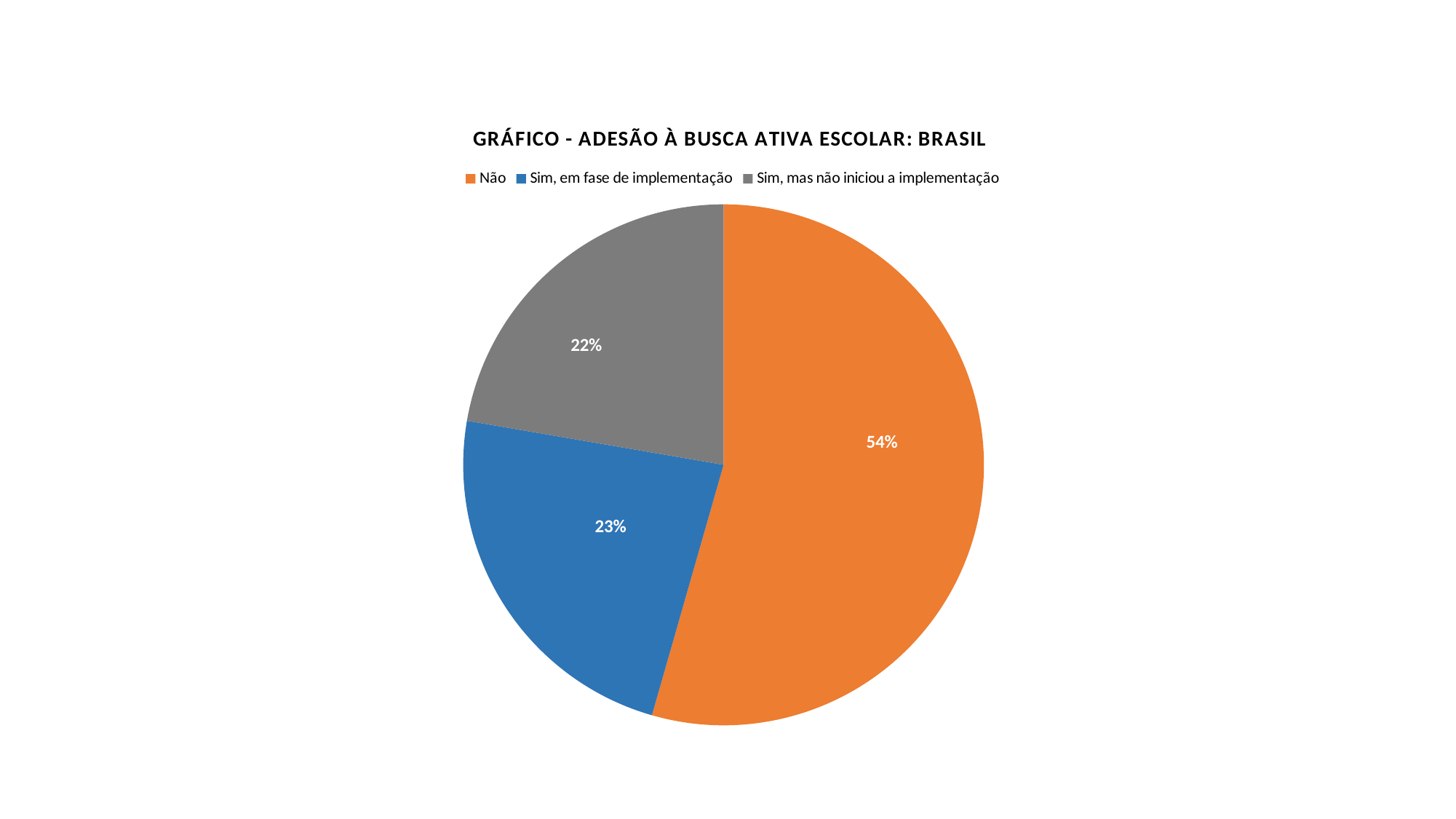
How many entries does the legend list? 3 What type of chart is shown on the slide? Pie chart What is the difference between the "Não" share and the "Sim, em fase de implementação" share? 31% Which category has the largest slice of the pie? Não Is the share for "Não" greater or less than 50%? greater How many slices does the pie chart have? 3 What share of the pie does the "Sim, mas não iniciou a implementação" slice represent? 22% What is the title of the chart? GRÁFICO - ADESÃO À BUSCA ATIVA ESCOLAR: BRASIL What is the difference between the "Sim, em fase de implementação" share and the "Sim, mas não iniciou a implementação" share? 1% What share of the pie does the "Não" slice represent? 54% What share of the pie does the "Sim, em fase de implementação" slice represent? 23% Which colour represents the "Não" category in the pie chart? Orange